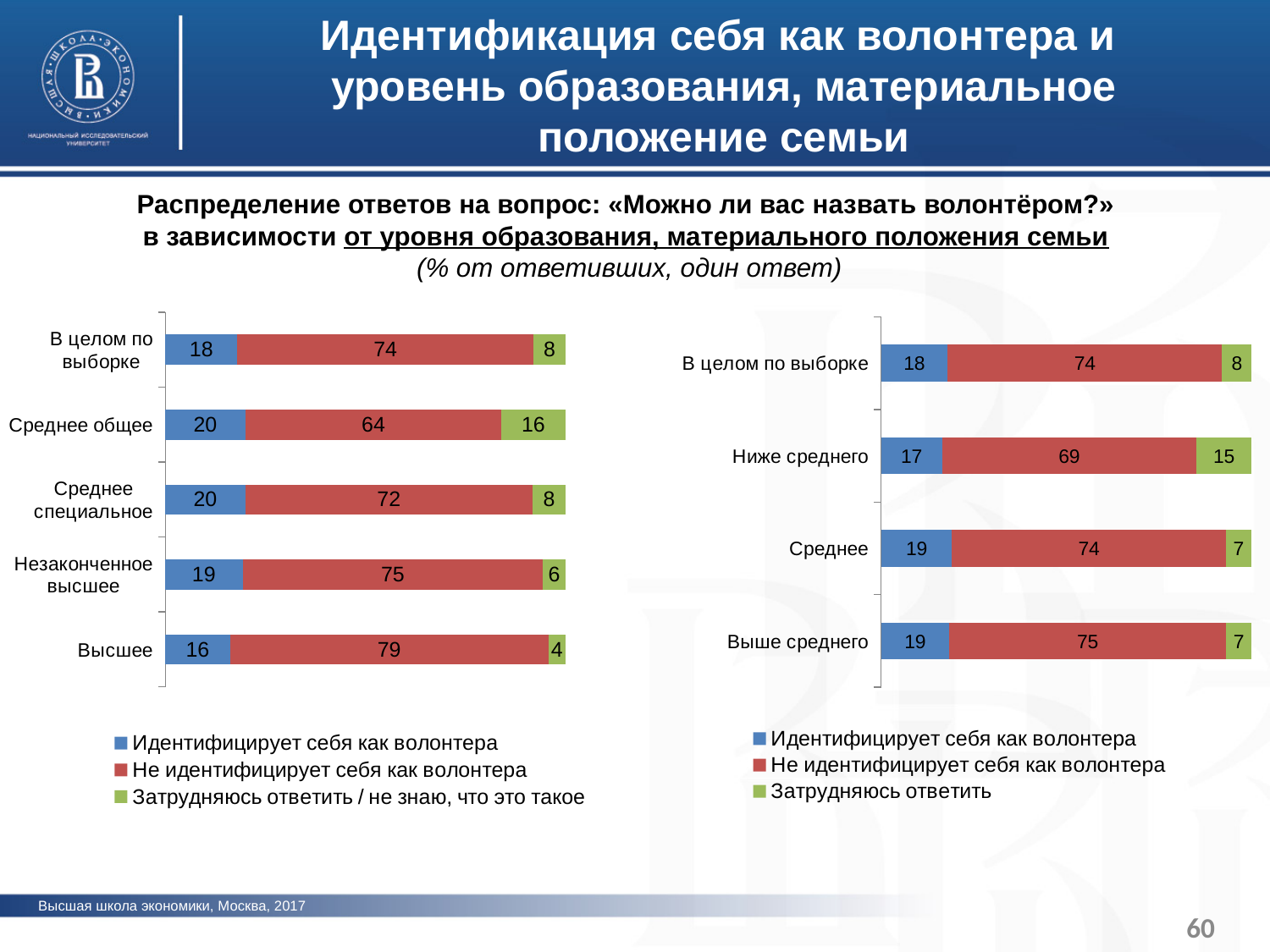
On the left chart (by education level), what is the total of the stacked bar for 'Среднее общее'? 100 How many series does the legend of the left chart (by education level) list? 3 On the right chart (by family financial situation), what colour represents 'Идентифицирует себя как волонтера'? Blue On the right chart (by family financial situation), what is the difference between the 'Не идентифицирует себя как волонтера' values for 'Выше среднего' and 'Ниже среднего'? 6 On the left chart (by education level), what is the value for 'Не идентифицирует себя как волонтера' in the 'Высшее' category? 79 How many categories are shown on the right chart (by family financial situation)? 4 What type of chart is the right chart (by family financial situation)? Stacked bar chart On the left chart (by education level), which category has the lowest value for 'Идентифицирует себя как волонтера'? Высшее On the left chart (by education level), which is larger: the 'Не идентифицирует себя как волонтера' value for 'Среднее общее' or for 'Среднее специальное'? Среднее специальное How many categories are shown on the left chart (by education level)? 5 On the left chart (by education level), which category has the highest value for 'Затрудняюсь ответить / не знаю, что это такое'? Среднее общее On the right chart (by family financial situation), what is the value for 'Затрудняюсь ответить' in the 'Ниже среднего' category? 15